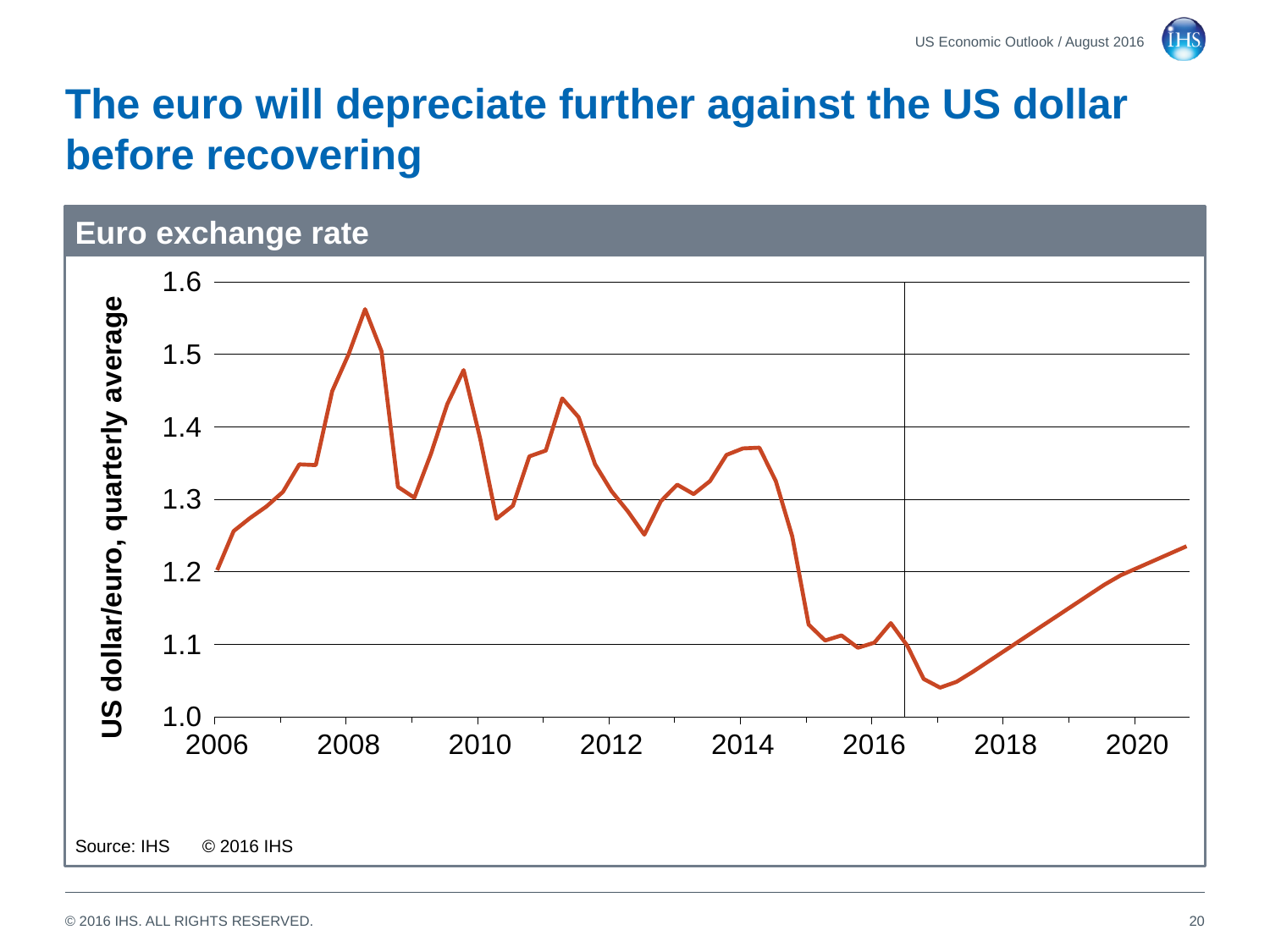
Which is higher, the peak in 2008 or the peak in 2010? the peak in 2008 What is the label on the vertical axis of the chart? US dollar/euro, quarterly average Is the peak value reached in 2008 greater or less than 1.5? greater What is the title of the chart? Euro exchange rate Is the value at the start of 2017 greater or less than 1.1? less Does the line rise or fall between 2014 and 2015? fall Is the value at the start of 2006 greater or less than 1.3? less In which year does the line reach its lowest value? 2017 In which year does the line reach its highest value? 2008 Does the line rise or fall between 2017 and 2020? rise What kind of chart is shown on the slide? line chart